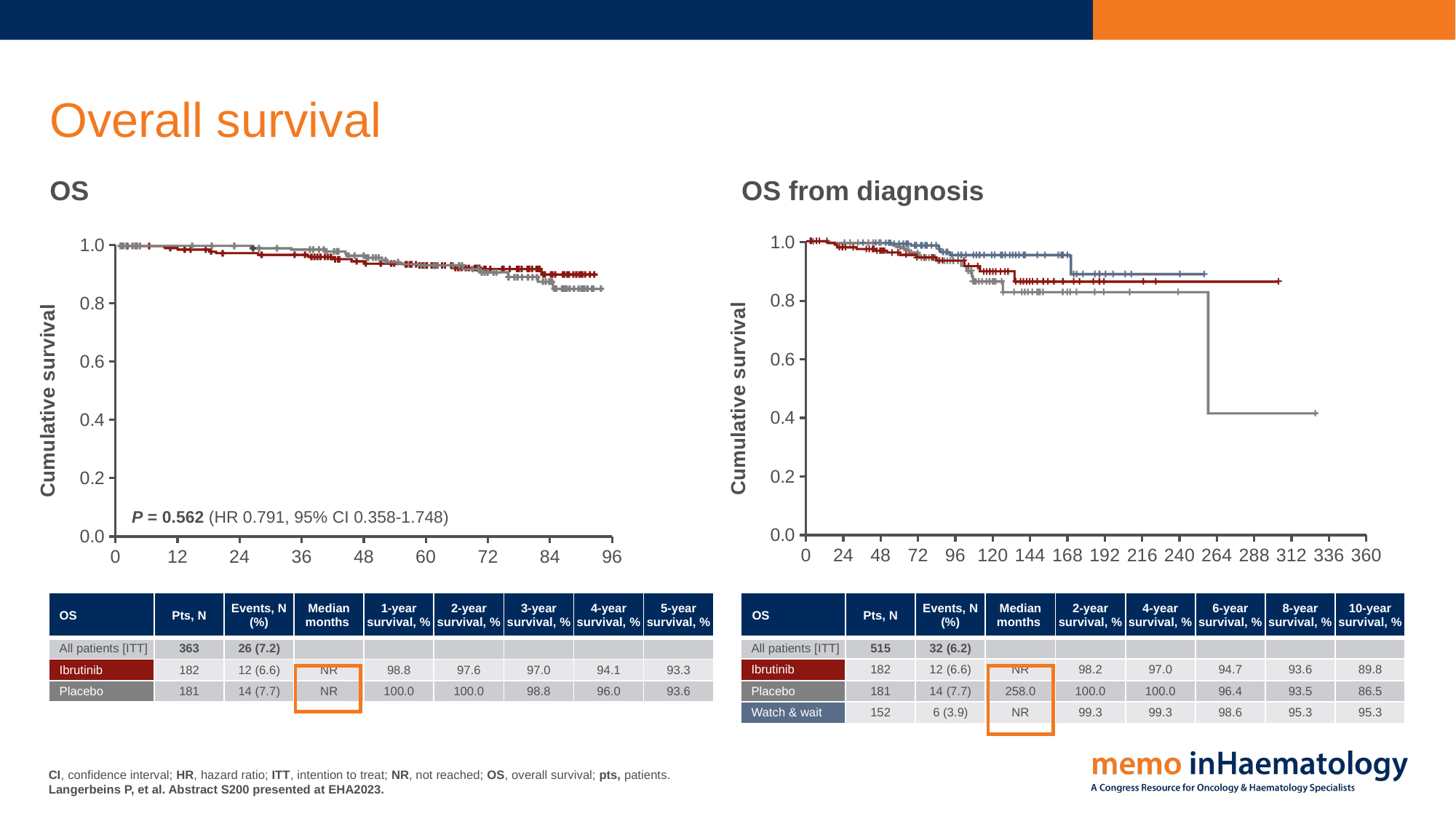
In the table under the 'OS from diagnosis' chart on the right, what is the 10-year survival, % for Watch & wait? 95.3 On the 'OS' chart on the left, what is the highest tick value shown on the x axis? 96 In the table under the 'OS from diagnosis' chart on the right, what is the median months value for Placebo? 258.0 How many survival curves are plotted on the 'OS from diagnosis' chart on the right? 3 What P value is printed on the 'OS' chart on the left? 0.562 On the 'OS from diagnosis' chart on the right, is the cumulative survival of the grey curve at 336 months greater or less than 0.6? less In the table under the 'OS from diagnosis' chart on the right, what is the difference in 10-year survival, % between Ibrutinib and Placebo? 3.3 In the table under the 'OS' chart on the left, what is the 5-year survival, % for Ibrutinib? 93.3 What kind of chart is the 'OS' chart on the left of the slide? line chart On the 'OS from diagnosis' chart on the right, what is the highest tick value shown on the x axis? 360 What hazard ratio (HR) is printed on the 'OS' chart on the left? 0.791 How many survival curves are plotted on the 'OS' chart on the left? 2